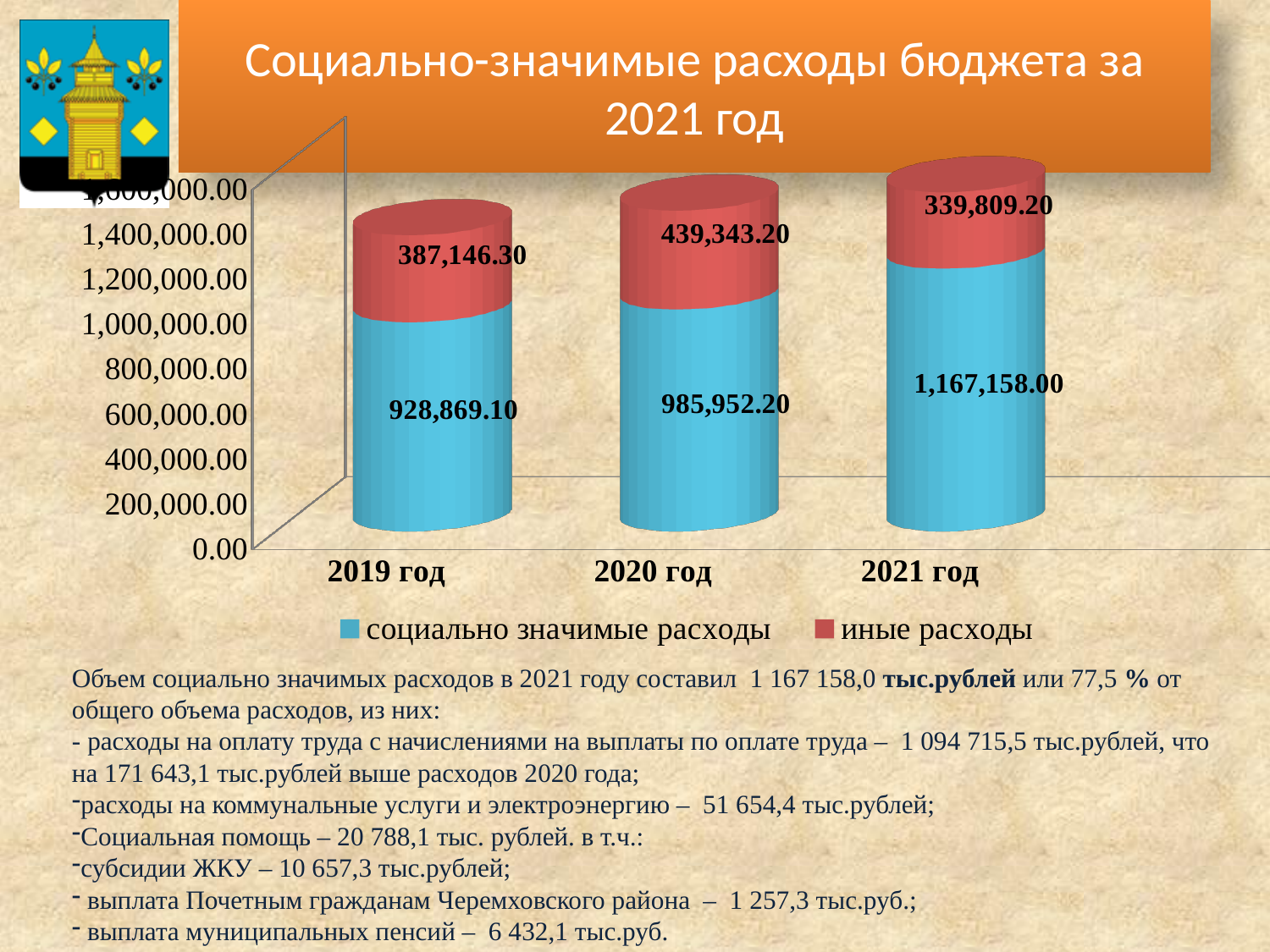
What is the total of the stacked bar for 2019 год? 1,316,015.40 How many years are shown on the x axis? 3 What is the value of иные расходы for 2019 год? 387,146.30 What kind of chart is shown on the slide? Stacked bar chart How many series does the legend list? 2 What is the value of социально значимые расходы for 2021 год? 1,167,158.00 What is the value of социально значимые расходы for 2020 год? 985,952.20 Which year has the highest value of социально значимые расходы? 2021 год Which year has the lowest value of иные расходы? 2021 год What is the difference between социально значимые расходы in 2021 год and 2020 год? 181,205.80 Do the values of социально значимые расходы rise or fall from 2019 год to 2021 год? Rise Which is larger: иные расходы in 2020 год or in 2021 год? 2020 год